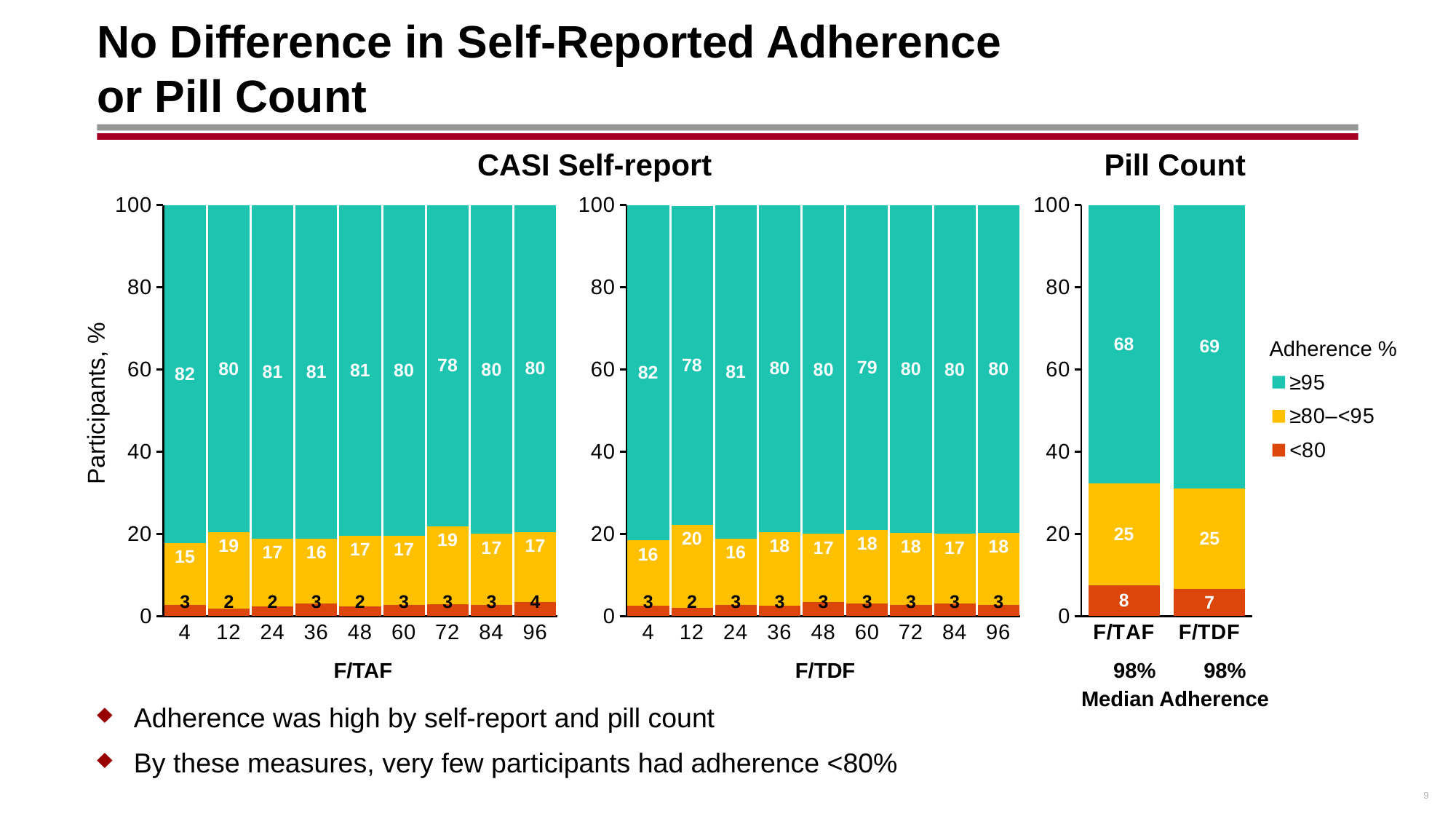
In the CASI Self-report F/TDF chart, what is the ≥80–<95 value at week 12? 20 In the Pill Count chart, what is the difference between the ≥95 values for F/TDF and F/TAF? 1 In the CASI Self-report F/TDF chart, which week has the larger ≥80–<95 value, week 12 or week 24? Week 12 What median adherence is shown below the F/TAF bar in the Pill Count chart? 98% In the CASI Self-report F/TAF chart, what is the difference between the <80 values at week 96 and week 12? 2 How many adherence categories does the legend list? 3 What type of chart is the Pill Count chart? Stacked bar chart In the Pill Count chart, what is the <80 adherence value for F/TAF? 8 In the CASI Self-report F/TAF chart, how many weeks are shown on the x axis? 9 In the CASI Self-report F/TAF chart, at which week is the ≥95 segment highest? 4 In the CASI Self-report F/TAF chart, at which week is the ≥95 segment lowest? 72 In the CASI Self-report F/TAF chart, what percentage of participants had ≥95 adherence at week 4? 82